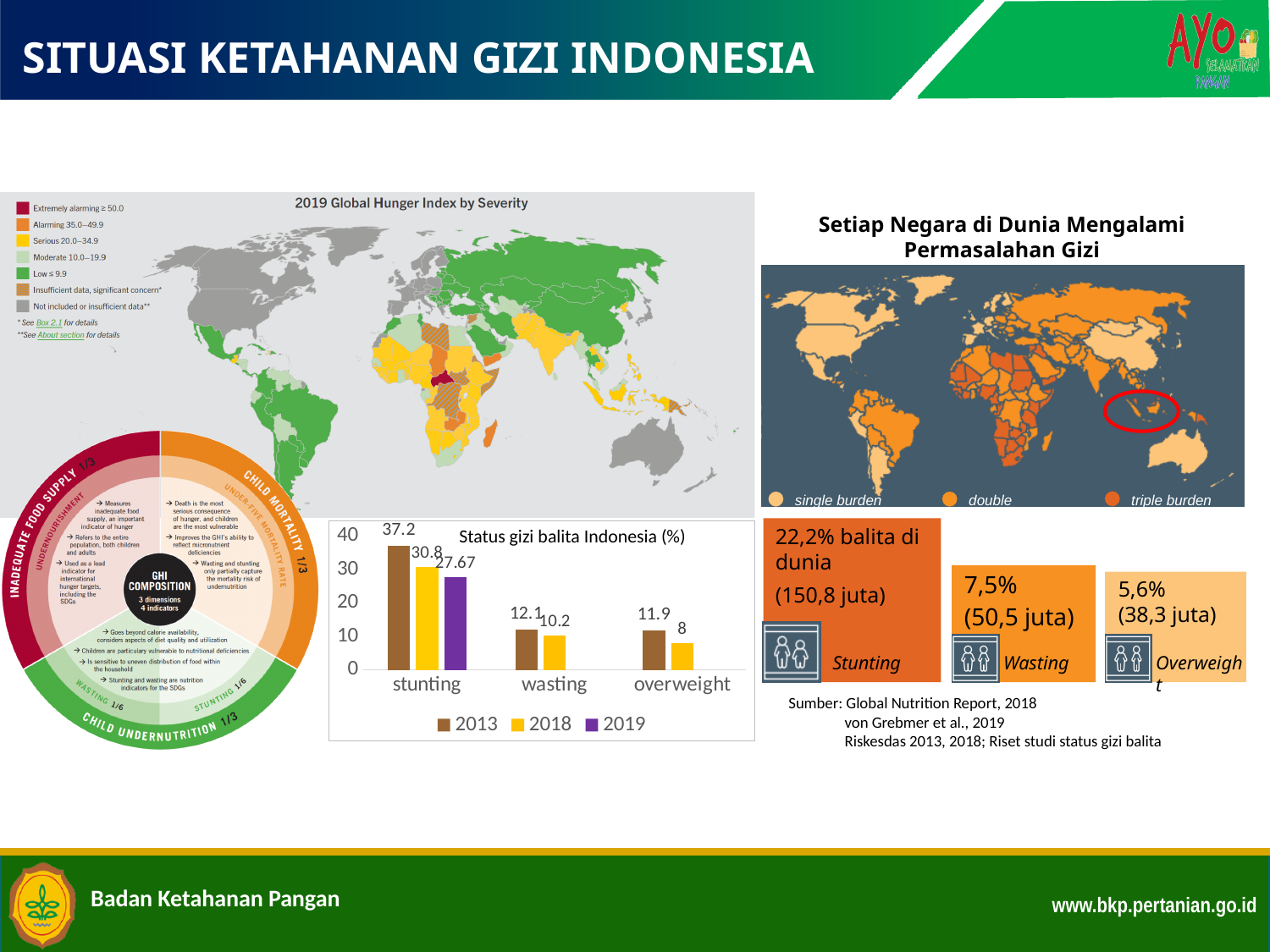
How many series does the legend of the chart 'Status gizi balita Indonesia (%)' list? 3 What kind of chart is 'Status gizi balita Indonesia (%)'? bar chart In the chart 'Status gizi balita Indonesia (%)', what is the difference between the stunting values for 2013 and 2018? 6.4 In the chart 'Status gizi balita Indonesia (%)', what is the value for overweight in 2018? 8 In the chart 'Status gizi balita Indonesia (%)', what is the value for wasting in 2018? 10.2 In the chart 'Status gizi balita Indonesia (%)', which category has the lowest value for 2018? overweight In the chart 'Status gizi balita Indonesia (%)', what is the value for stunting in 2013? 37.2 In the chart 'Status gizi balita Indonesia (%)', which category has the highest value for 2013? stunting In the chart 'Status gizi balita Indonesia (%)', is the value for stunting in 2018 greater or less than 20? greater How many categories are shown on the x axis of the chart 'Status gizi balita Indonesia (%)'? 3 In the chart 'Status gizi balita Indonesia (%)', what is the value for stunting in 2019? 27.67 In the chart 'Status gizi balita Indonesia (%)', which is larger: wasting in 2013 or overweight in 2013? wasting in 2013